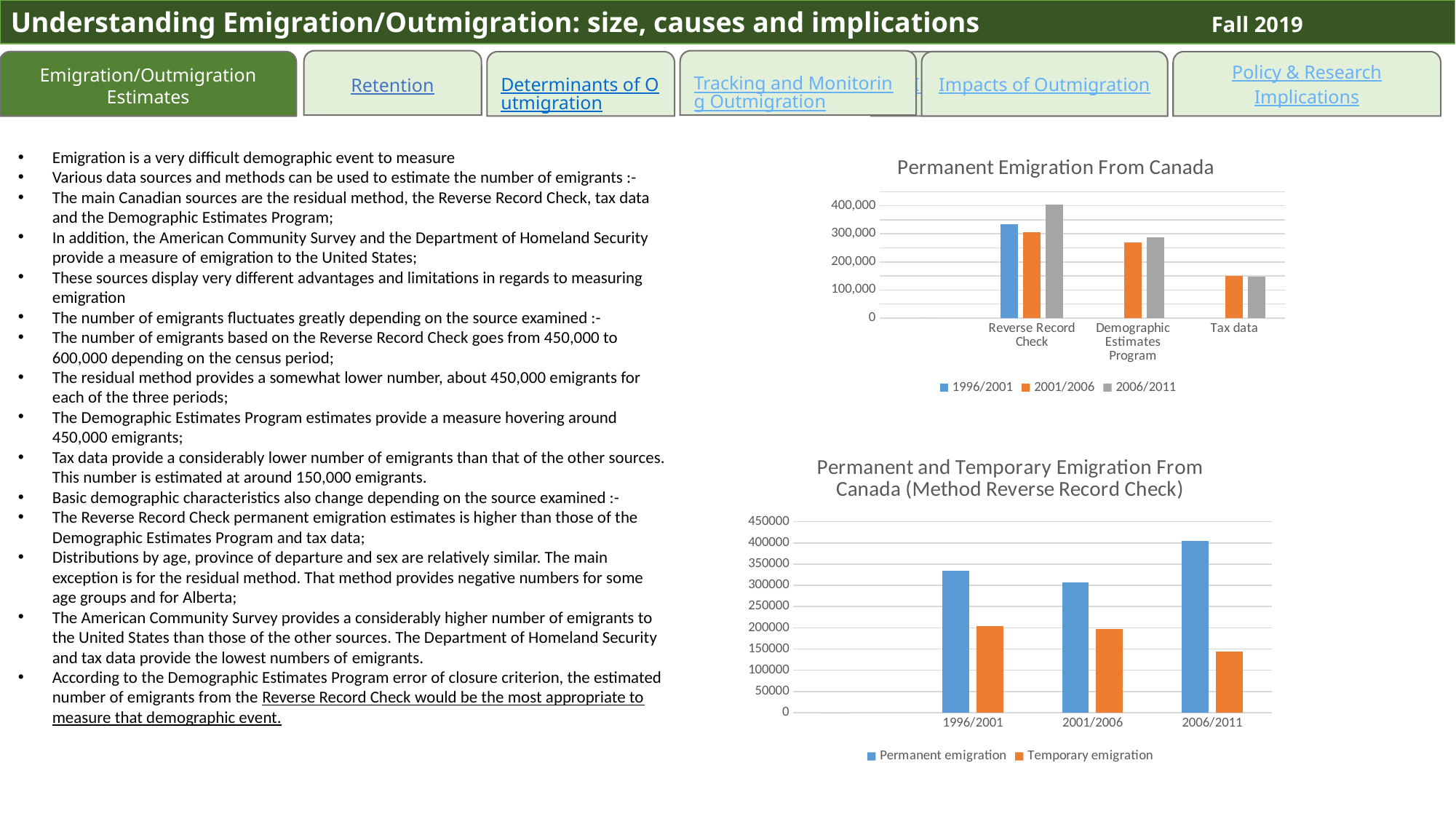
In the "Permanent Emigration From Canada" chart, which data source has the lowest 2006/2011 value? Tax data In the "Permanent Emigration From Canada" chart, is the 2006/2011 value for Reverse Record Check greater or less than 300,000? greater In the "Permanent and Temporary Emigration From Canada (Method Reverse Record Check)" chart, does Temporary emigration rise or fall from 1996/2001 to 2006/2011? Fall How many series does the legend of the "Permanent Emigration From Canada" chart list? 3 How many series does the legend of the "Permanent and Temporary Emigration From Canada (Method Reverse Record Check)" chart list? 2 What type of chart is the "Permanent Emigration From Canada" chart? Bar chart How many data sources are shown on the x axis of the "Permanent Emigration From Canada" chart? 3 In the "Permanent Emigration From Canada" chart, which period has the larger value for Reverse Record Check: 2001/2006 or 2006/2011? 2006/2011 In the "Permanent Emigration From Canada" chart, which data source has the highest 2006/2011 value? Reverse Record Check In the "Permanent Emigration From Canada" chart, is the 2001/2006 value for Tax data greater or less than 200,000? less In the "Permanent and Temporary Emigration From Canada (Method Reverse Record Check)" chart, is Permanent emigration for 2006/2011 greater or less than 350000? greater In the "Permanent and Temporary Emigration From Canada (Method Reverse Record Check)" chart, which period has the highest Permanent emigration? 2006/2011